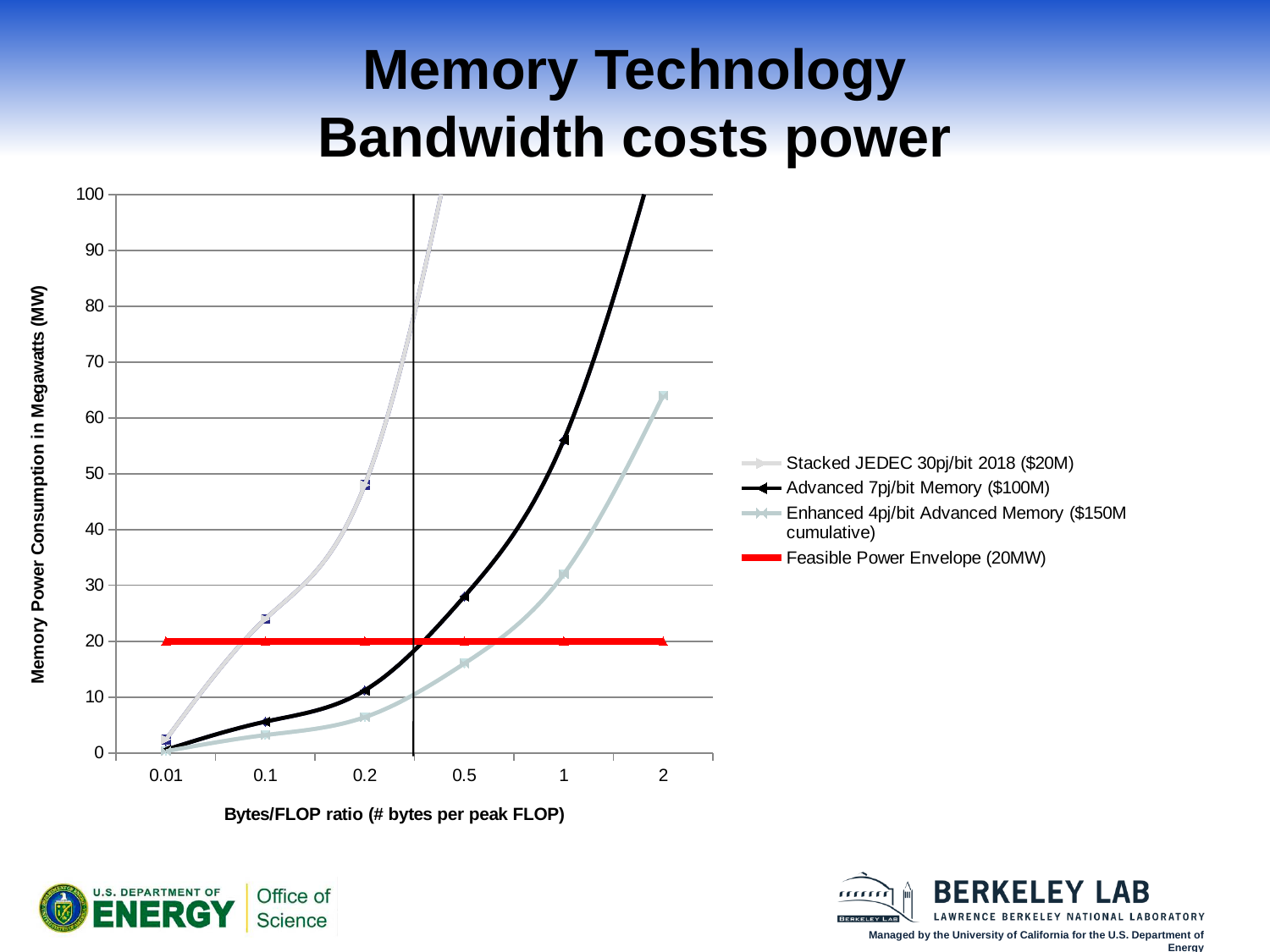
What kind of chart is shown on the slide? line chart What is the value of the Feasible Power Envelope line? 20MW At a Bytes/FLOP ratio of 1, which is larger: Advanced 7pj/bit Memory or Enhanced 4pj/bit Advanced Memory? Advanced 7pj/bit Memory Do the values for Advanced 7pj/bit Memory rise or fall as the Bytes/FLOP ratio increases? rise How many tick labels are shown on the x axis (Bytes/FLOP ratio)? 6 How many series does the legend list? 4 Is the value for Stacked JEDEC 30pj/bit 2018 at a Bytes/FLOP ratio of 0.2 greater or less than 40? greater Is the value for Enhanced 4pj/bit Advanced Memory at a Bytes/FLOP ratio of 0.5 greater or less than 20? less Is the value for Enhanced 4pj/bit Advanced Memory at a Bytes/FLOP ratio of 2 greater or less than 60? greater Which series has the highest value at a Bytes/FLOP ratio of 0.2? Stacked JEDEC 30pj/bit 2018 ($20M) What is the title of the y axis? Memory Power Consumption in Megawatts (MW)